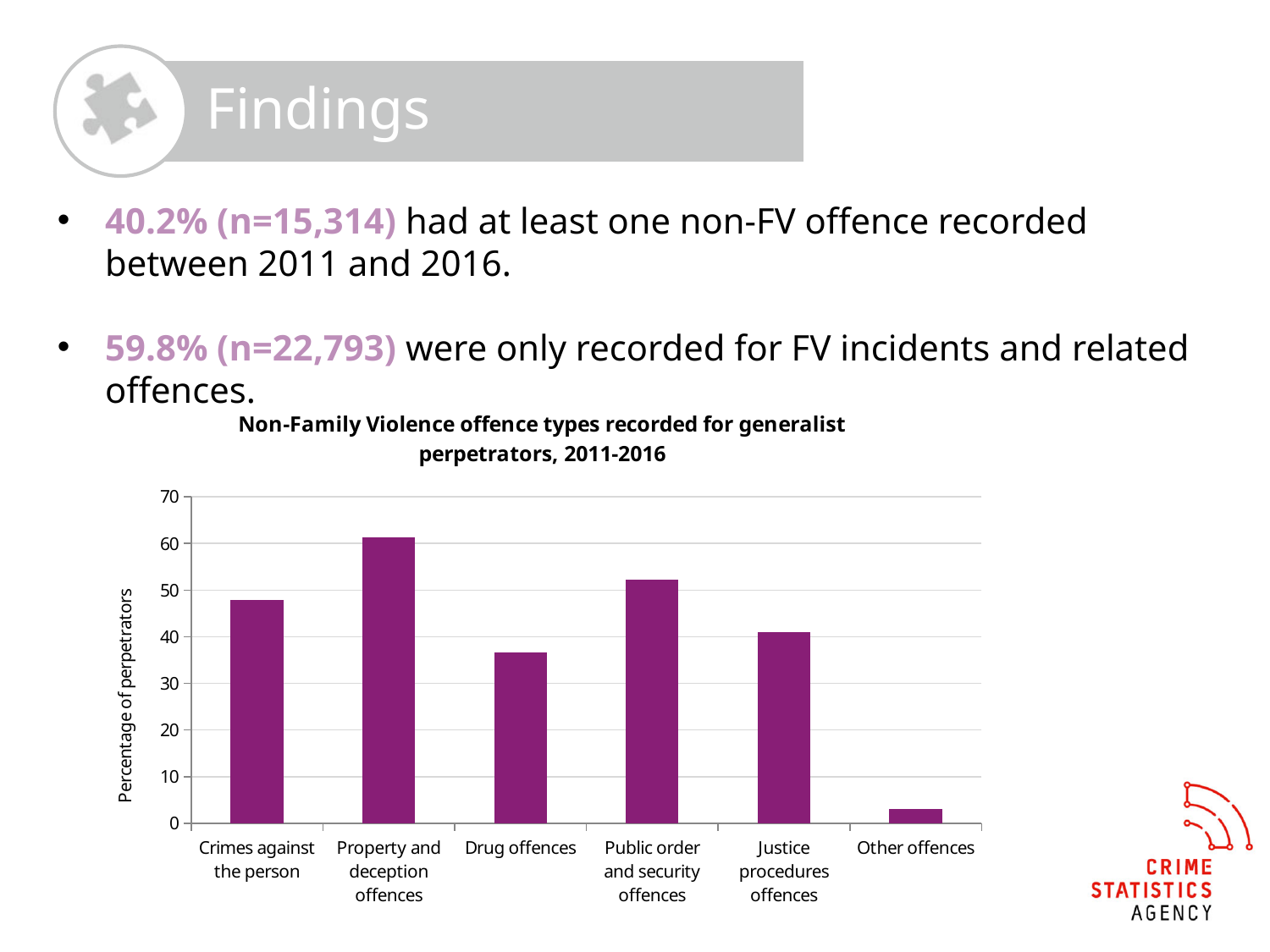
Is the value for Other offences greater or less than 10? less Is the value for Public order and security offences greater or less than 50? greater What is the label on the vertical axis of the chart? Percentage of perpetrators What type of chart is shown on the slide? Bar chart Which is larger: the value for Public order and security offences or the value for Drug offences? Public order and security offences Which offence type has the highest percentage of perpetrators? Property and deception offences What is the title of the chart? Non-Family Violence offence types recorded for generalist perpetrators, 2011-2016 Which is larger: the value for Crimes against the person or the value for Justice procedures offences? Crimes against the person Which offence type has the lowest percentage of perpetrators? Other offences How many offence type categories are shown on the chart? 6 Is the value for Property and deception offences greater or less than 60? greater